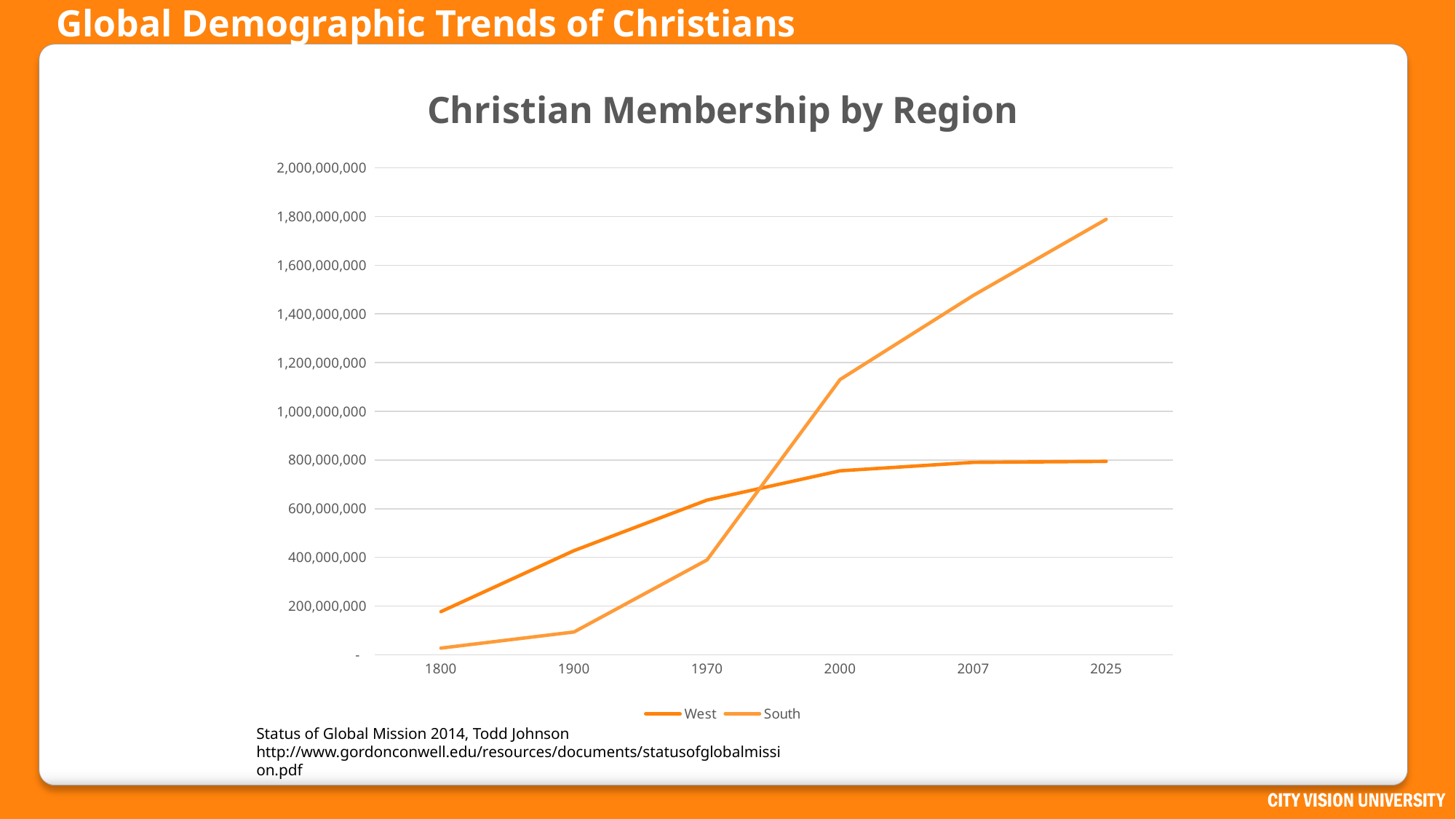
How many years are shown along the x axis? 6 In 1900, which series has the larger value, West or South? West Is the value for West in 2000 greater or less than 600,000,000? greater How many series does the legend list? 2 What kind of chart is shown on the slide? line chart In which year is the West series at its lowest value? 1800 Does the South series rise or fall from 1800 to 2025? rise Is the value for West in 2025 greater or less than 1,000,000,000? less What is the title of the chart? Christian Membership by Region Is the value for South in 2025 greater or less than 1,600,000,000? greater In 2025, which series has the larger value, West or South? South